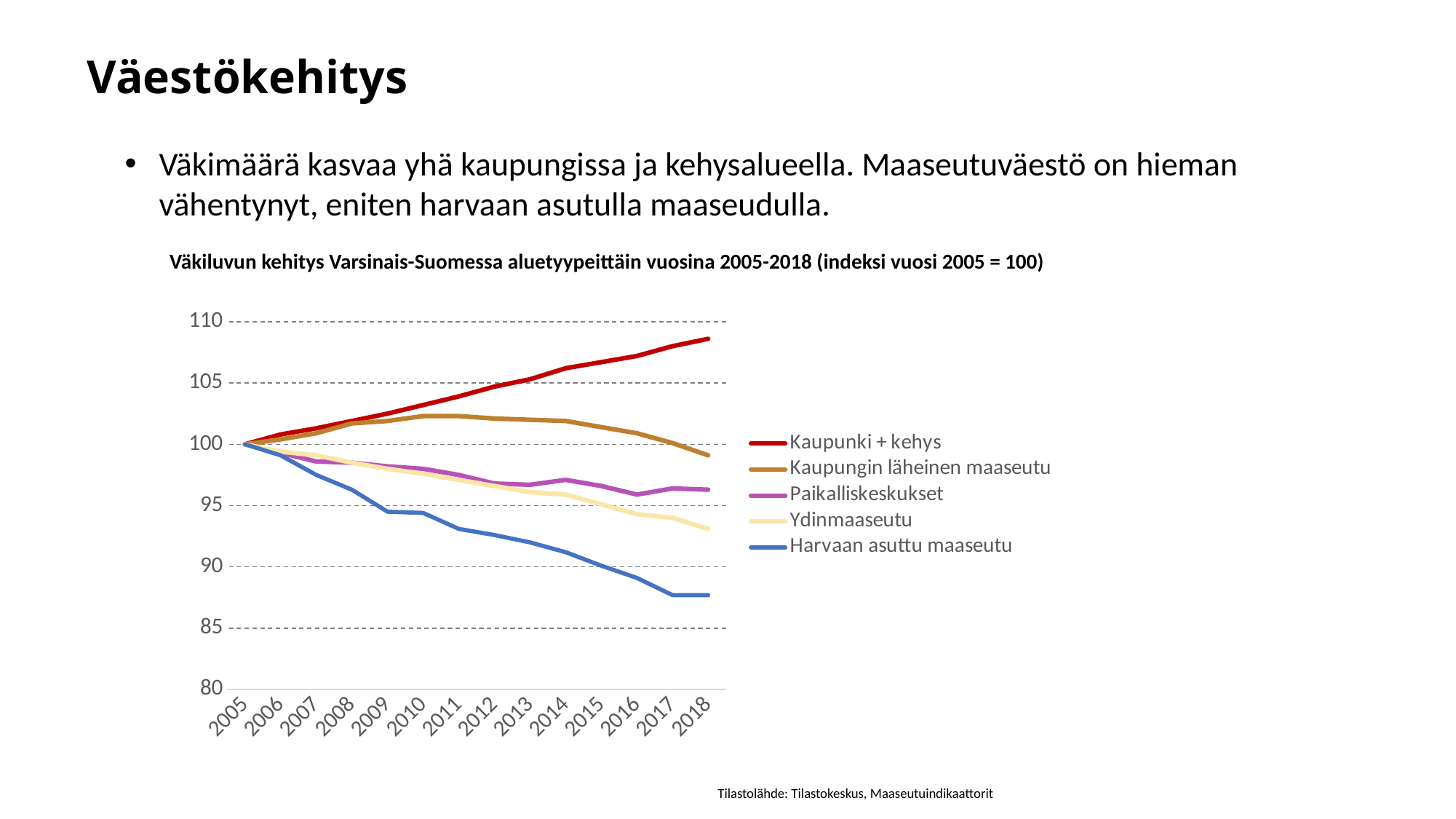
What is the title of the chart? Väkiluvun kehitys Varsinais-Suomessa aluetyypeittäin vuosina 2005-2018 (indeksi vuosi 2005 = 100) Is the value for Harvaan asuttu maaseutu in 2018 greater or less than 90? less What kind of chart is shown on the slide? line chart Is the value for Ydinmaaseutu in 2018 greater or less than 95? less Is the value for Kaupunki + kehys in 2018 greater or less than 105? greater Which series has the lowest value in 2018? Harvaan asuttu maaseutu How many series does the legend list? 5 Does the Harvaan asuttu maaseutu series rise or fall from 2005 to 2018? fall How many years are shown on the x axis? 14 Which series has the highest value in 2018? Kaupunki + kehys In 2018, which is larger: Paikalliskeskukset or Ydinmaaseutu? Paikalliskeskukset